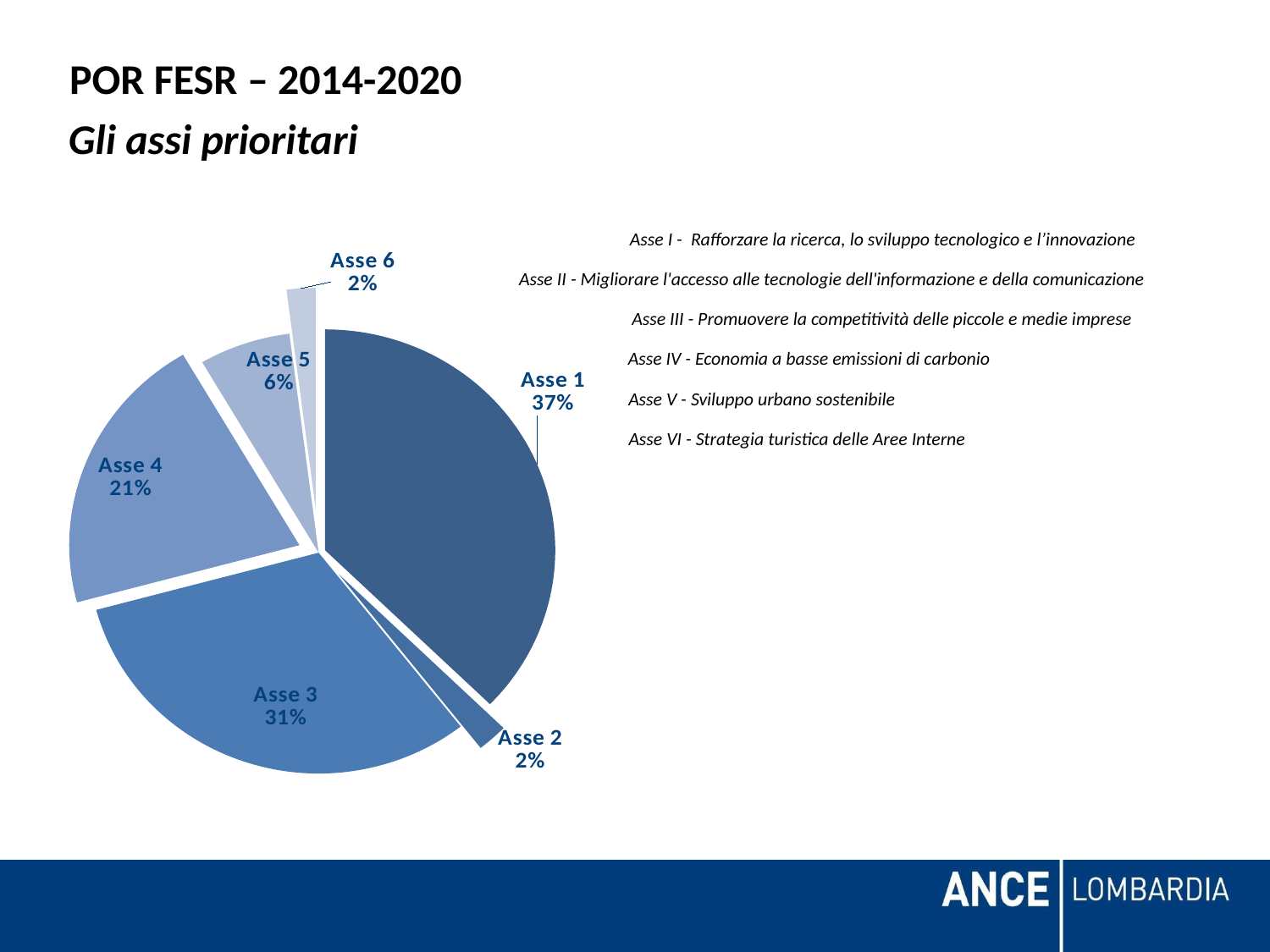
What is the value shown for Asse 5? 6% What is the combined share of Asse 2 and Asse 6? 4% Which is larger, Asse 5 or Asse 6? Asse 5 How many slices does the pie chart have? 6 What is the difference in percentage points between Asse 4 and Asse 5? 15 What share of the pie does Asse 3 represent? 31% What kind of chart is shown on the slide? pie chart Which is larger, Asse 3 or Asse 4? Asse 3 What share of the pie does Asse 1 represent? 37% What is the difference in percentage points between Asse 1 and Asse 3? 6 Which slice of the pie is the largest? Asse 1 What is the value shown for Asse 4? 21%